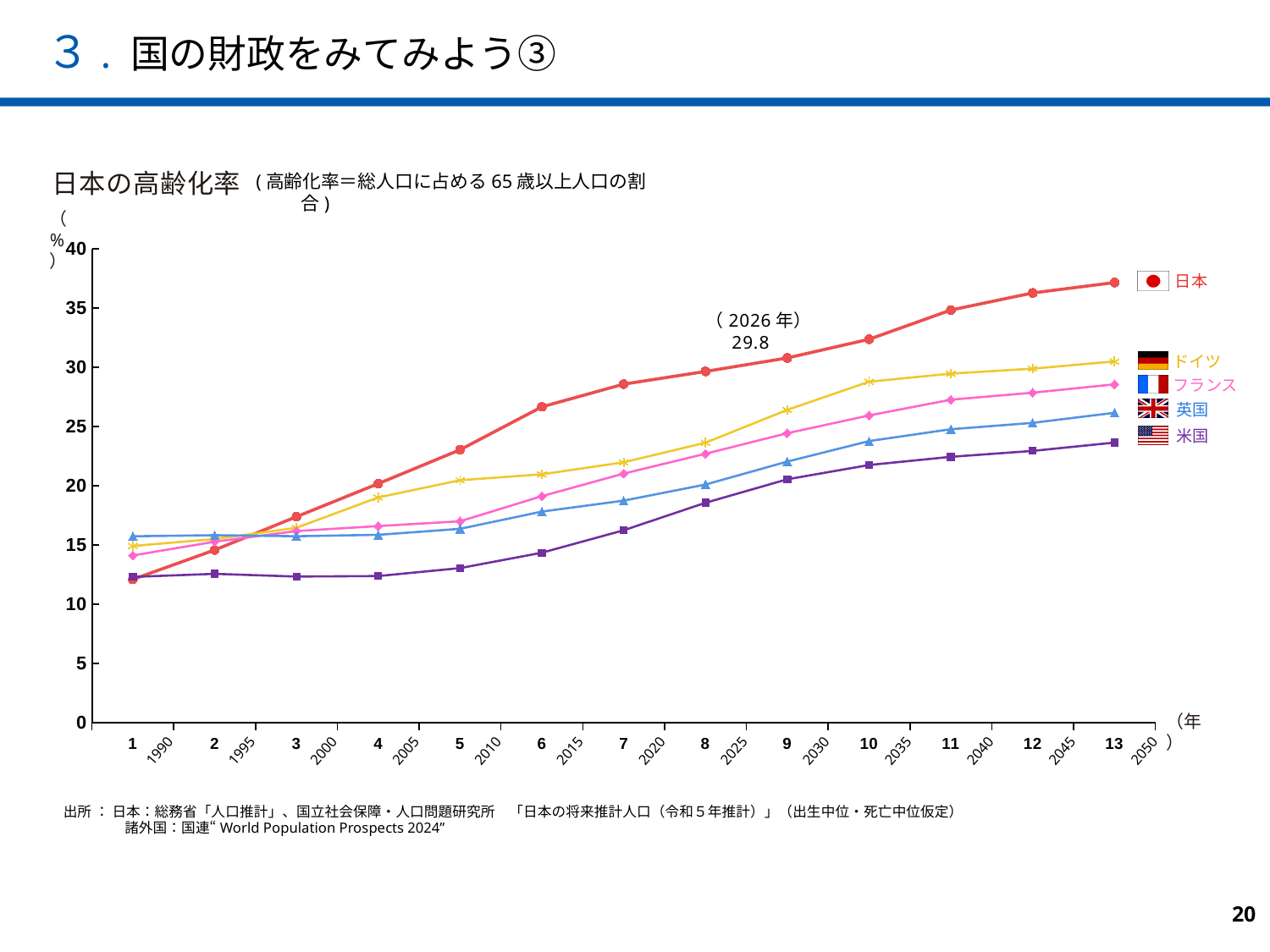
Is the value for 米国 at point 1 greater or less than 15? less Which series has the lowest value at the last point (13) on the x axis? 米国 How many data points are plotted along the x axis for each series? 13 Does the 日本 line rise or fall from left to right along the x axis? rise How many series does the legend list? 5 Is the value for フランス at point 13 greater or less than 30? less Which series has the highest value at the last point (13) on the x axis? 日本 What is the title of the chart? 日本の高齢化率 At point 13, which is larger: the value for 日本 or the value for 米国? 日本 Is the value for 日本 at point 13 greater or less than 35? greater What value is labelled on the 日本 line for 2026年? 29.8 What kind of chart is shown on the slide? line chart